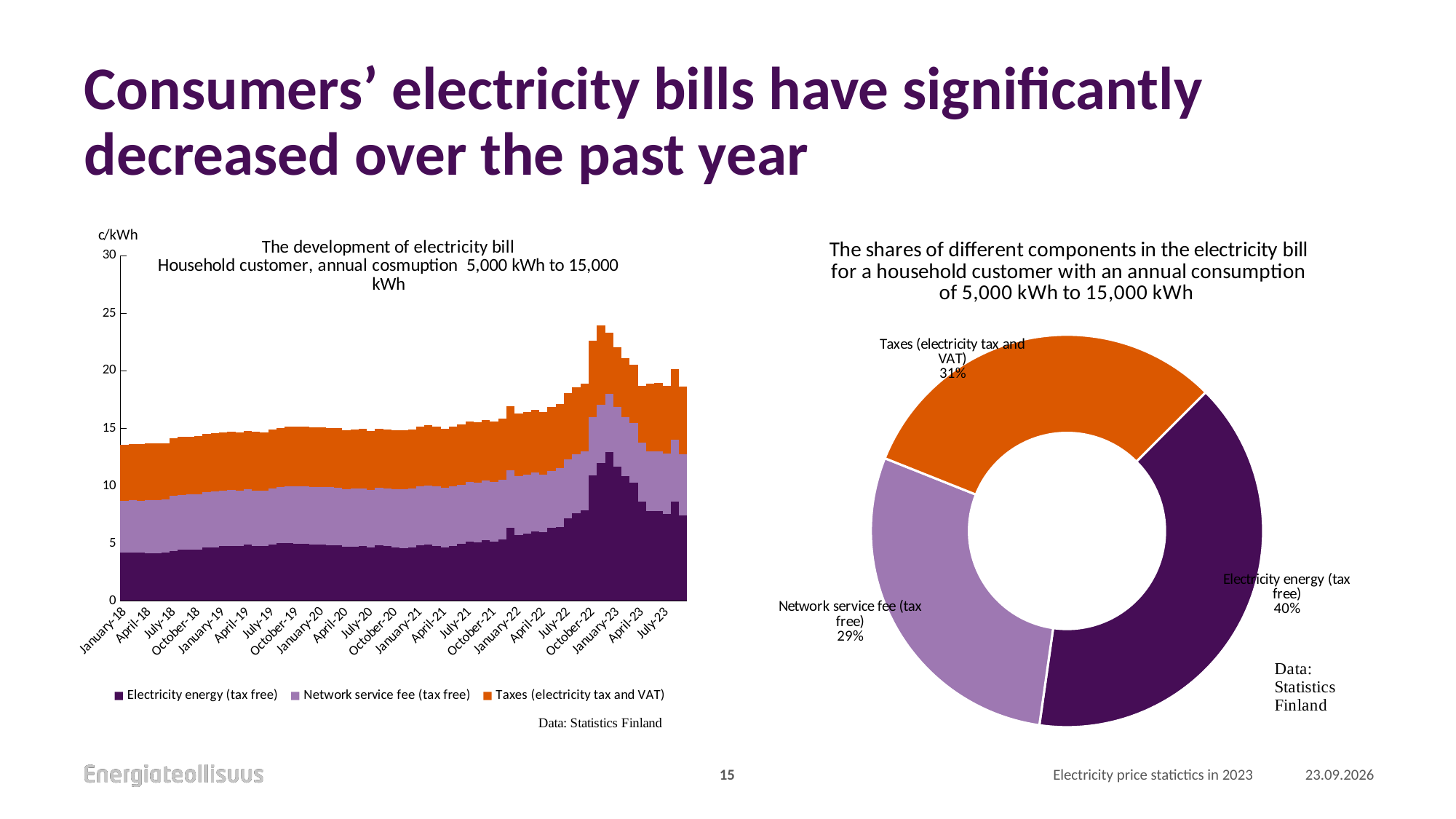
In the doughnut chart on the right, what share of the electricity bill is Taxes (electricity tax and VAT)? 31% In the doughnut chart on the right, what share of the electricity bill is Electricity energy (tax free)? 40% In the doughnut chart on the right, how many percentage points larger is the Electricity energy share than the Network service fee share? 11 percentage points In the left chart, 'The development of electricity bill', is the total bill at its peak around January-23 greater or less than 20 c/kWh? greater In the left chart, 'The development of electricity bill', is the total bill for January-18 greater or less than 15 c/kWh? less In the doughnut chart on the right, what share of the electricity bill is Network service fee (tax free)? 29% In the doughnut chart on the right, which is larger: the share of Taxes or the share of Network service fee? Taxes (electricity tax and VAT) How many series does the legend of the left chart, 'The development of electricity bill', list? 3 What kind of chart is the left chart, 'The development of electricity bill'? Stacked bar chart How many slices does the doughnut chart on the right have? 3 In the doughnut chart on the right, which component has the largest share of the electricity bill? Electricity energy (tax free) In the doughnut chart on the right, which component has the smallest share of the electricity bill? Network service fee (tax free)